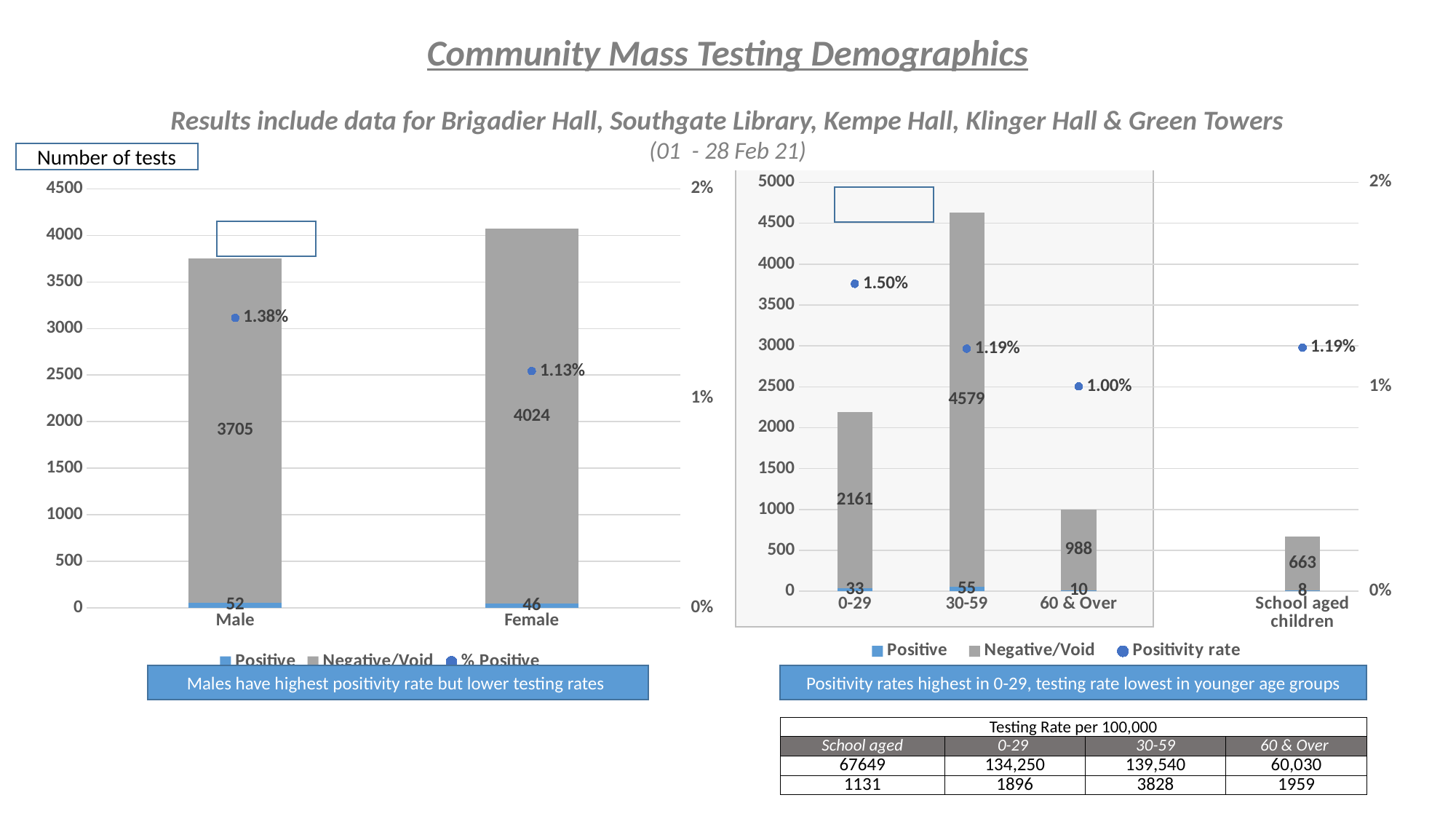
On the left chart (by gender), what is the total number of tests (Positive plus Negative/Void) for Female? 4070 On the left chart (by gender), what is the Negative/Void value for Male? 3705 On the right chart (by age group), what is the total number of tests (Positive plus Negative/Void) for 60 & Over? 998 On the right chart (by age group), what is the Negative/Void value for 30-59? 4579 On the left chart (by gender), what is the difference between the Negative/Void values for Female and Male? 319 On the left chart (by gender), how many series does the legend list? 3 On the left chart (by gender), which category has the higher % Positive value? Male On the right chart (by age group), what is the Positivity rate for 0-29? 1.50% On the left chart (by gender), what is the % Positive value for Female? 1.13% On the right chart (by age group), how many categories are shown on the x axis? 4 On the right chart (by age group), which age group has the lowest Positivity rate? 60 & Over On the right chart (by age group), which category has the highest Negative/Void value? 30-59